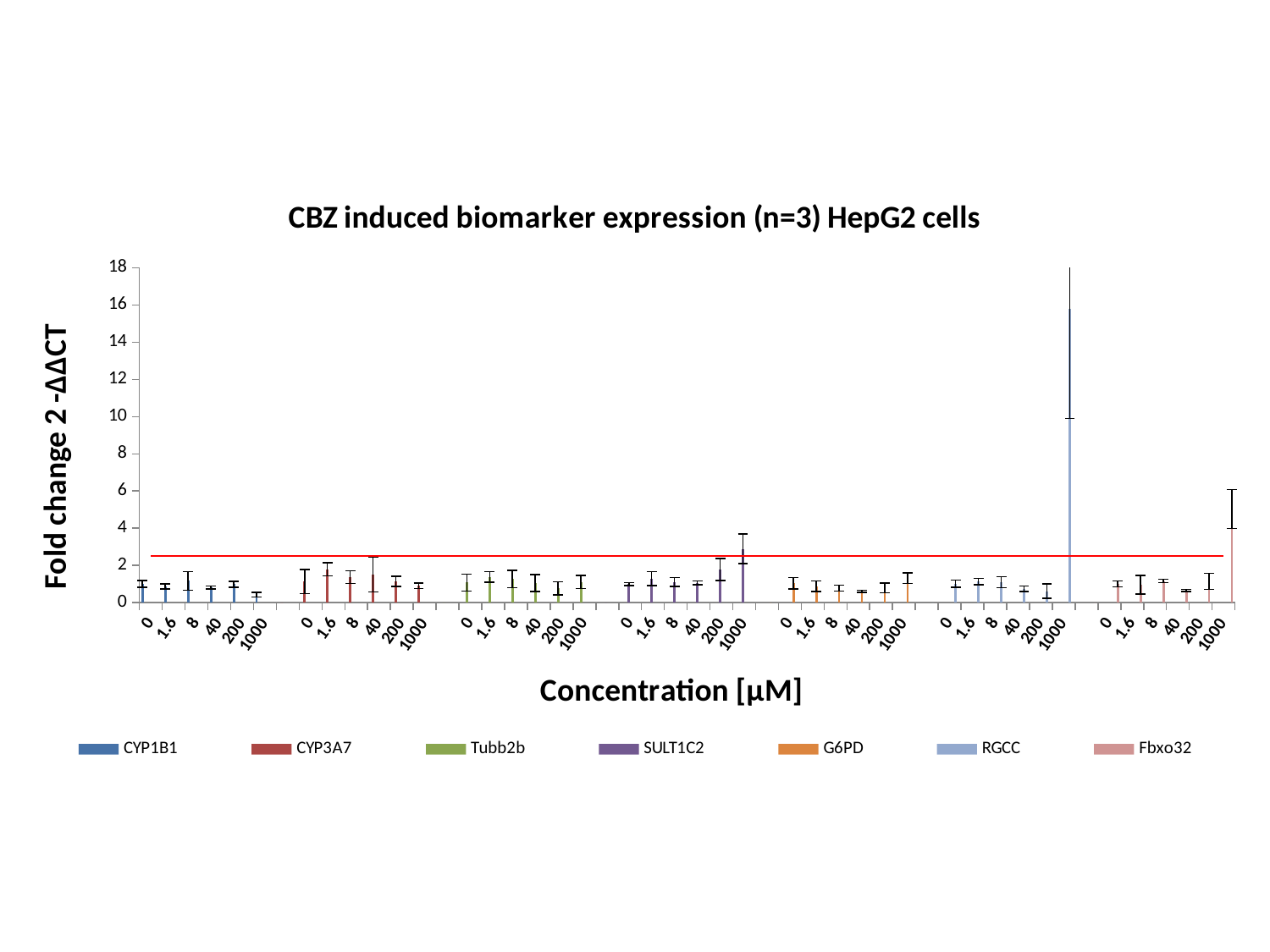
Is the value for SULT1C2 at 1000 µM greater or less than 6? less At which concentration does RGCC reach its highest fold change? 1000 What is the title of the chart? CBZ induced biomarker expression (n=3) HepG2 cells How many series does the legend list? 7 Is the value for CYP1B1 at 0 µM greater or less than 2? less Which is larger, the value for RGCC at 1000 µM or the value for Fbxo32 at 1000 µM? RGCC at 1000 µM What kind of chart is shown on the slide? bar chart How many concentration levels are plotted for each biomarker series? 6 What is the label of the x axis? Concentration [µM] Which series has the tallest bar in the chart? RGCC Is the value for RGCC at 1000 µM greater or less than 8? greater